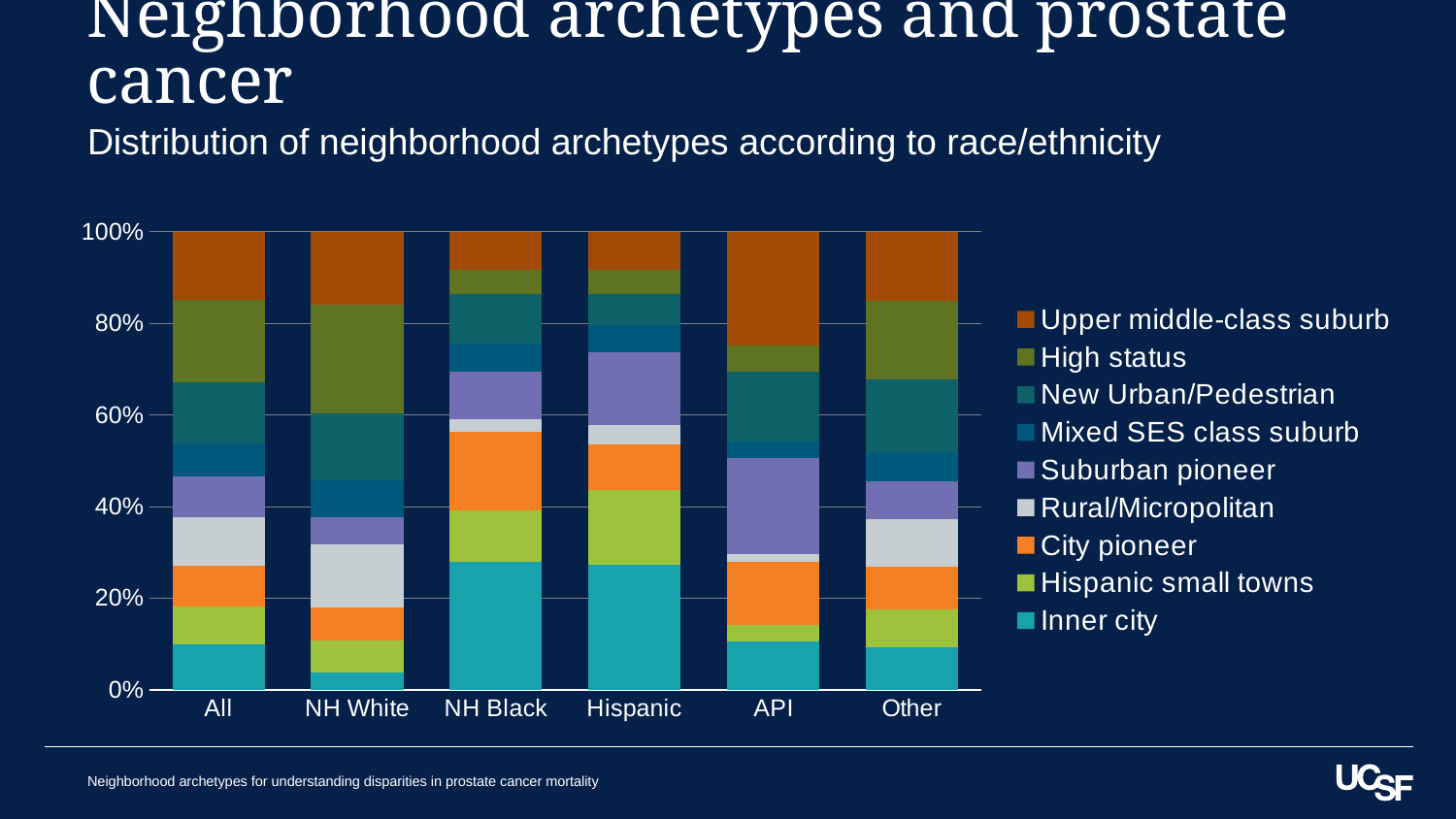
Which race/ethnicity group has the largest Suburban pioneer share? API Is the Inner city share for NH White greater or less than 20%? less What kind of chart is shown on the slide? Stacked bar chart Which has a larger Inner city share, NH Black or NH White? NH Black Which race/ethnicity group has the largest Rural/Micropolitan share? NH White Which race/ethnicity group has the largest Upper middle-class suburb share? API Is the Inner city share for NH Black greater or less than 20%? greater What is the subtitle describing the chart? Distribution of neighborhood archetypes according to race/ethnicity How many race/ethnicity categories are shown on the x axis? 6 Which race/ethnicity group has the smallest Inner city share? NH White Which series appears at the bottom of each stacked bar? Inner city How many neighborhood archetype series does the legend list? 9